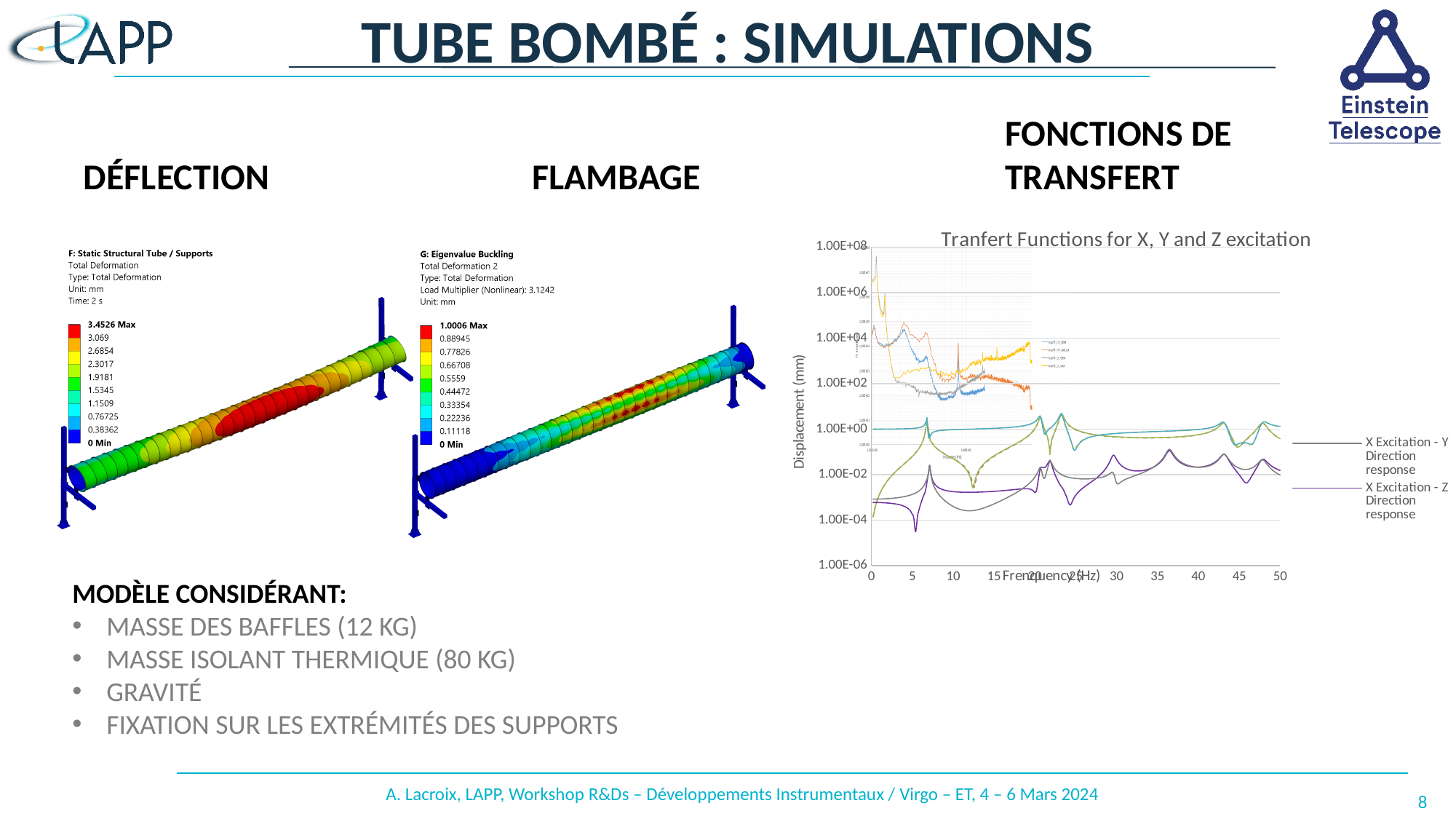
In the 'Tranfert Functions' chart, what is the label of the x axis? Frequency (Hz) How many series entries are readable in the legend of the 'Tranfert Functions' chart? 2 In the 'Tranfert Functions' chart, is the value of the 'X Excitation - Z Direction response' series at 5 Hz greater or less than 1.00E+00? less In the DÉFLECTION simulation image, what is the maximum total deformation shown in the colour legend? 3.4526 Max What kind of chart is the 'Tranfert Functions for X, Y and Z excitation' chart? line chart In the FLAMBAGE simulation image, what is the Load Multiplier (Nonlinear) value shown? 3.1242 What is the title of the chart under 'FONCTIONS DE TRANSFERT'? Tranfert Functions for X, Y and Z excitation In the FLAMBAGE simulation image, what is the maximum value shown in the colour legend? 1.0006 Max In the 'Tranfert Functions' chart, what is the highest tick value shown on the y axis? 1.00E+08 In the 'Tranfert Functions' chart, what is the maximum frequency shown on the x axis? 50 In the 'Tranfert Functions' chart, what is the lowest tick value shown on the y axis? 1.00E-06 In the 'Tranfert Functions' chart, is the value of the 'X Excitation - Y Direction response' series at 45 Hz greater or less than 1.00E+00? less